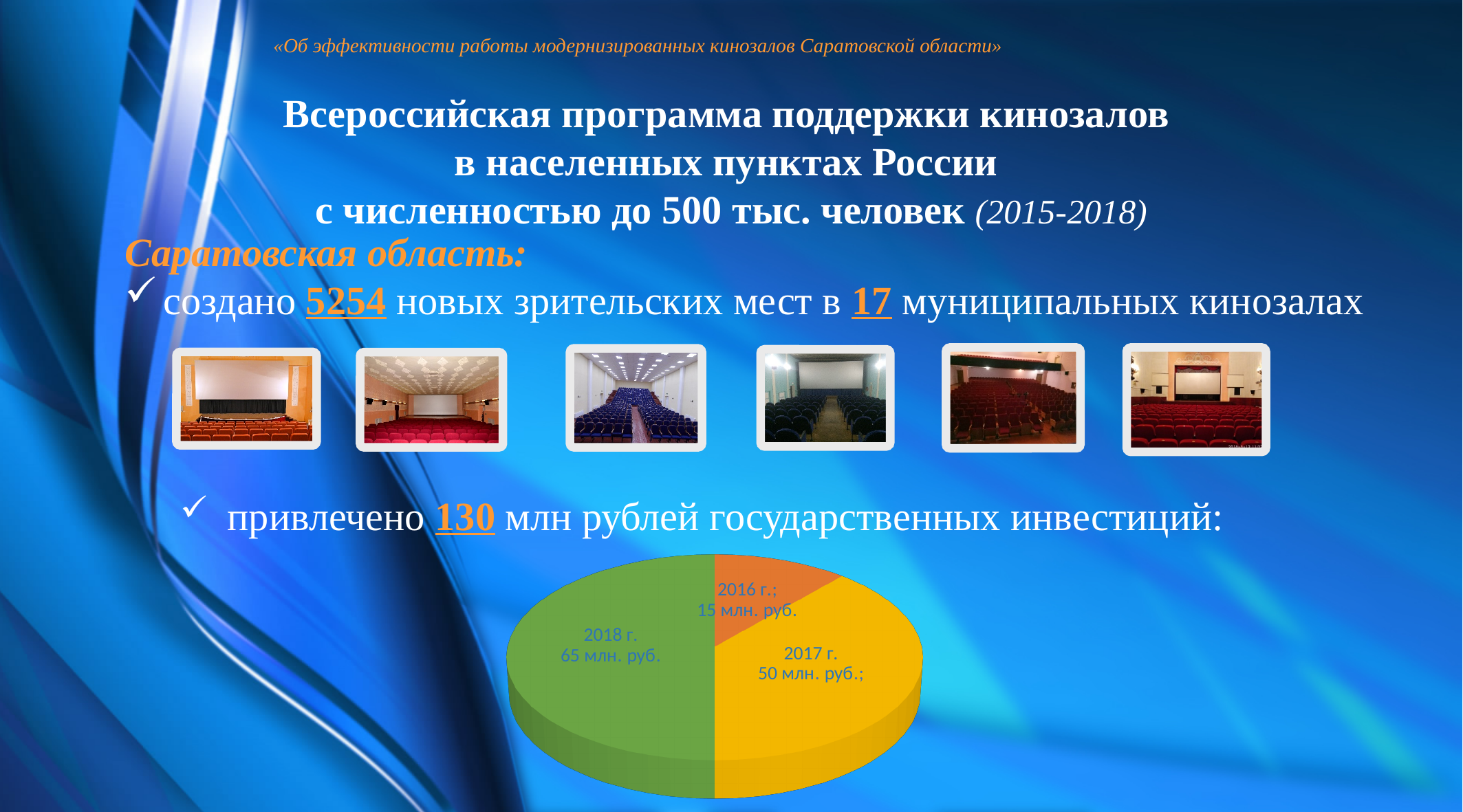
What is the value for 2017 г. in the pie chart? 50 млн. руб. What is the value for 2016 г. in the pie chart? 15 млн. руб. How many slices does the pie chart have? 3 What colour is the slice for 2018 г. in the pie chart? green Which year has the largest slice in the pie chart? 2018 г. Which is larger in the pie chart, the value for 2017 г. or 2016 г.? 2017 г. What is the difference between the values for 2017 г. and 2016 г. in the pie chart? 35 млн. руб. Which year has the smallest slice in the pie chart? 2016 г. What is the difference between the values for 2018 г. and 2017 г. in the pie chart? 15 млн. руб. What is the value for 2018 г. in the pie chart? 65 млн. руб. What is the total of all slices in the pie chart? 130 млн. руб. What kind of chart is shown on the slide? pie chart